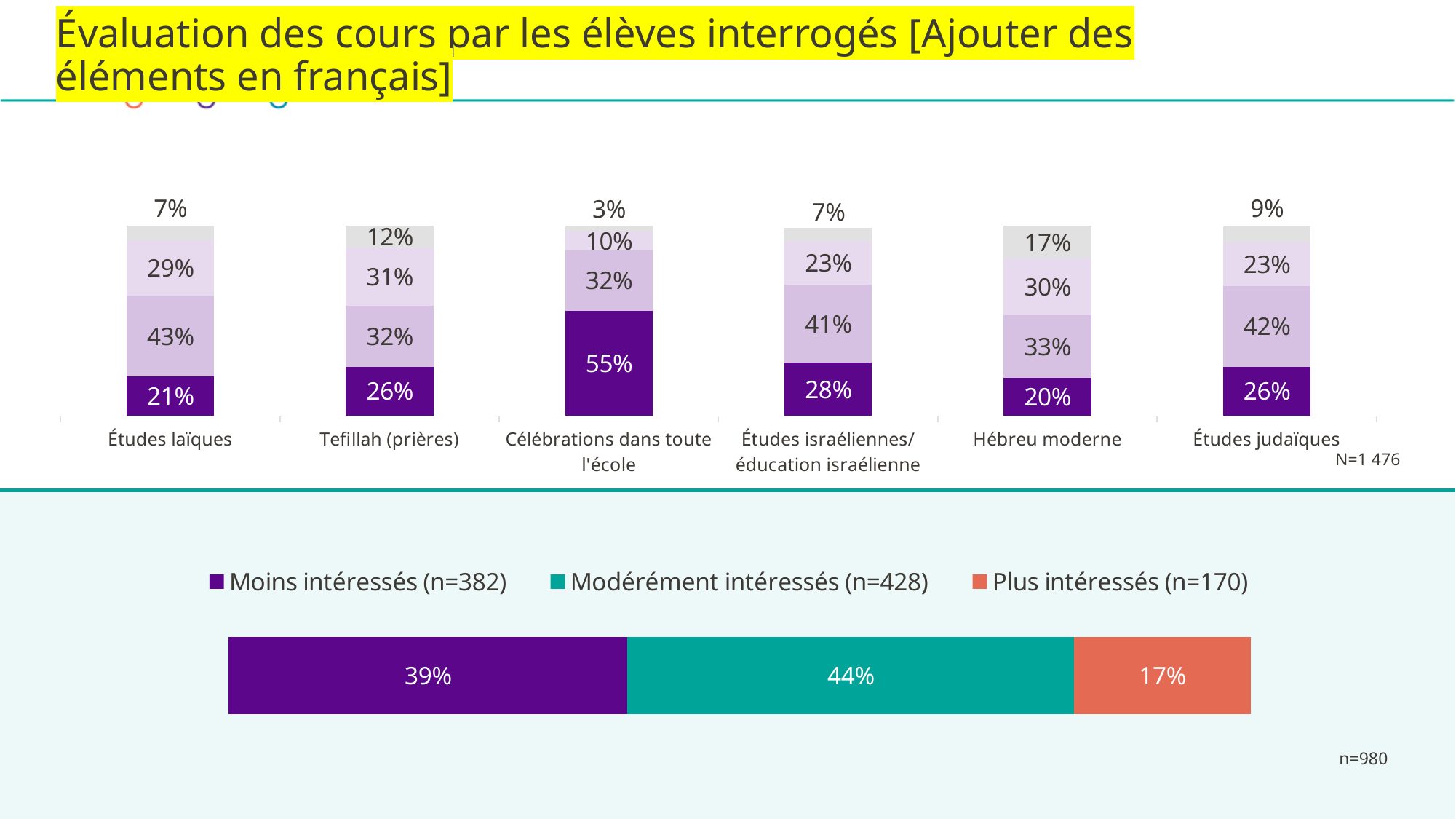
How many series does the legend of the bottom chart list? 3 In the bottom chart, which segment is the smallest? Plus intéressés (n=170) What kind of chart is the top chart? Stacked bar chart In the top chart, how many course categories are shown on the x axis? 6 In the top chart, what is the value printed above the bar for Études judaïques? 9% In the bottom chart, what is the value for Modérément intéressés? 44% In the top chart, what is the total of all segments of the Études laïques bar? 100% In the top chart, what is the value of the dark purple bottom segment for Célébrations dans toute l'école? 55% In the bottom chart, what is the difference between Modérément intéressés and Moins intéressés? 5 percentage points In the bottom chart, which is larger: Moins intéressés or Plus intéressés? Moins intéressés In the top chart, which category has the largest dark purple bottom segment? Célébrations dans toute l'école In the top chart, which category has the smallest dark purple bottom segment? Hébreu moderne